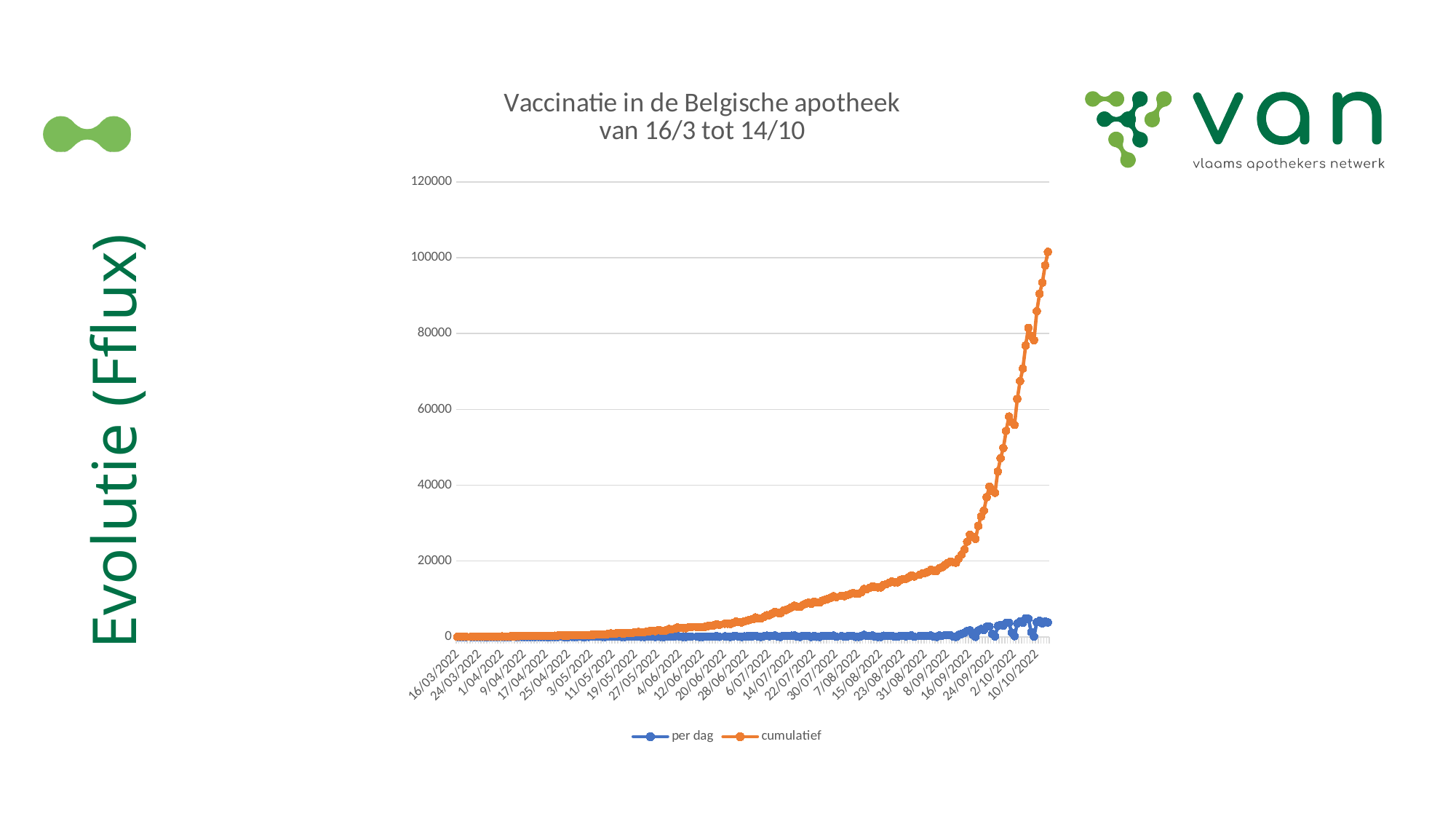
What kind of chart is shown on the slide? line chart Is the value of 'cumulatief' on 2/10/2022 greater or less than 40000? greater What is the title of the chart? Vaccinatie in de Belgische apotheek van 16/3 tot 14/10 Is the value of 'cumulatief' at the last date (10/10/2022) greater or less than 80000? greater Which series has the larger value on 10/10/2022, 'per dag' or 'cumulatief'? cumulatief Does the 'cumulatief' series rise or fall along the x axis? rise How many series does the legend list? 2 Is the value of 'per dag' on 10/10/2022 greater or less than 20000? less Which colour is used for the 'cumulatief' series? orange